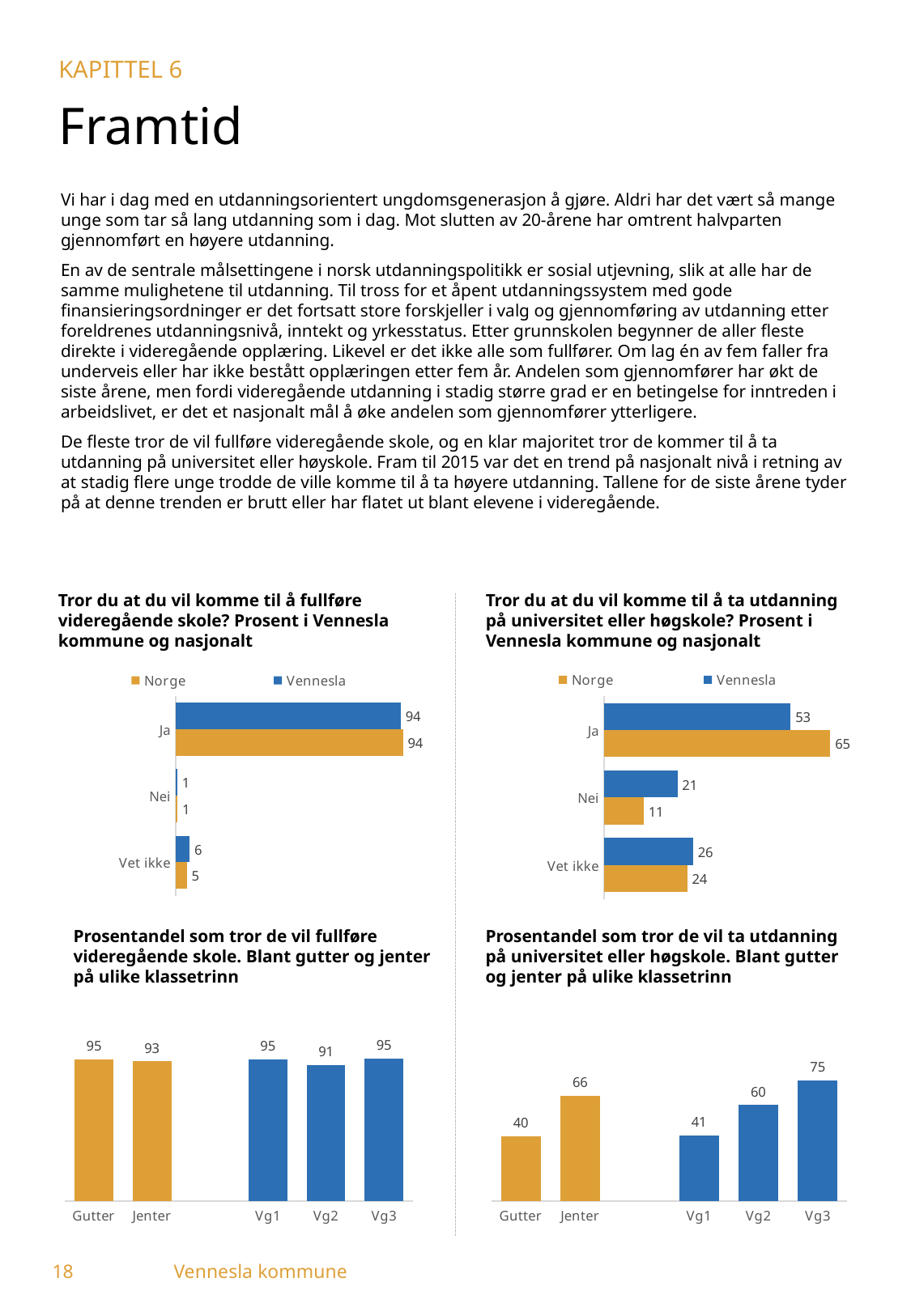
In the bottom-right chart (Prosentandel som tror de vil ta utdanning på universitet eller høgskole), which category has the highest value? Vg3 In the top-left chart (Tror du at du vil komme til å fullføre videregående skole?), how many series does the legend list? 2 In the top-left chart (Tror du at du vil komme til å fullføre videregående skole?), what is the value for Norge for 'Ja'? 94 In the bottom-left chart (Prosentandel som tror de vil fullføre videregående skole), how many categories are shown on the x axis? 5 In the top-right chart (Tror du at du vil komme til å ta utdanning på universitet eller høgskole?), what is the difference between Vennesla and Norge for 'Nei'? 10 In the bottom-right chart (Prosentandel som tror de vil ta utdanning på universitet eller høgskole), what is the difference between Jenter and Gutter? 26 In the top-right chart (Tror du at du vil komme til å ta utdanning på universitet eller høgskole?), what is the value for Norge for 'Ja'? 65 In the top-right chart (Tror du at du vil komme til å ta utdanning på universitet eller høgskole?), which is larger for 'Vet ikke', Vennesla or Norge? Vennesla In the bottom-right chart (Prosentandel som tror de vil ta utdanning på universitet eller høgskole), do the values rise or fall from Vg1 to Vg3? Rise In the top-left chart (Tror du at du vil komme til å fullføre videregående skole?), what is the value for Vennesla for 'Vet ikke'? 6 In the bottom-left chart (Prosentandel som tror de vil fullføre videregående skole), what is the value for Vg2? 91 What kind of chart is the top-right chart (Tror du at du vil komme til å ta utdanning på universitet eller høgskole?)? Bar chart